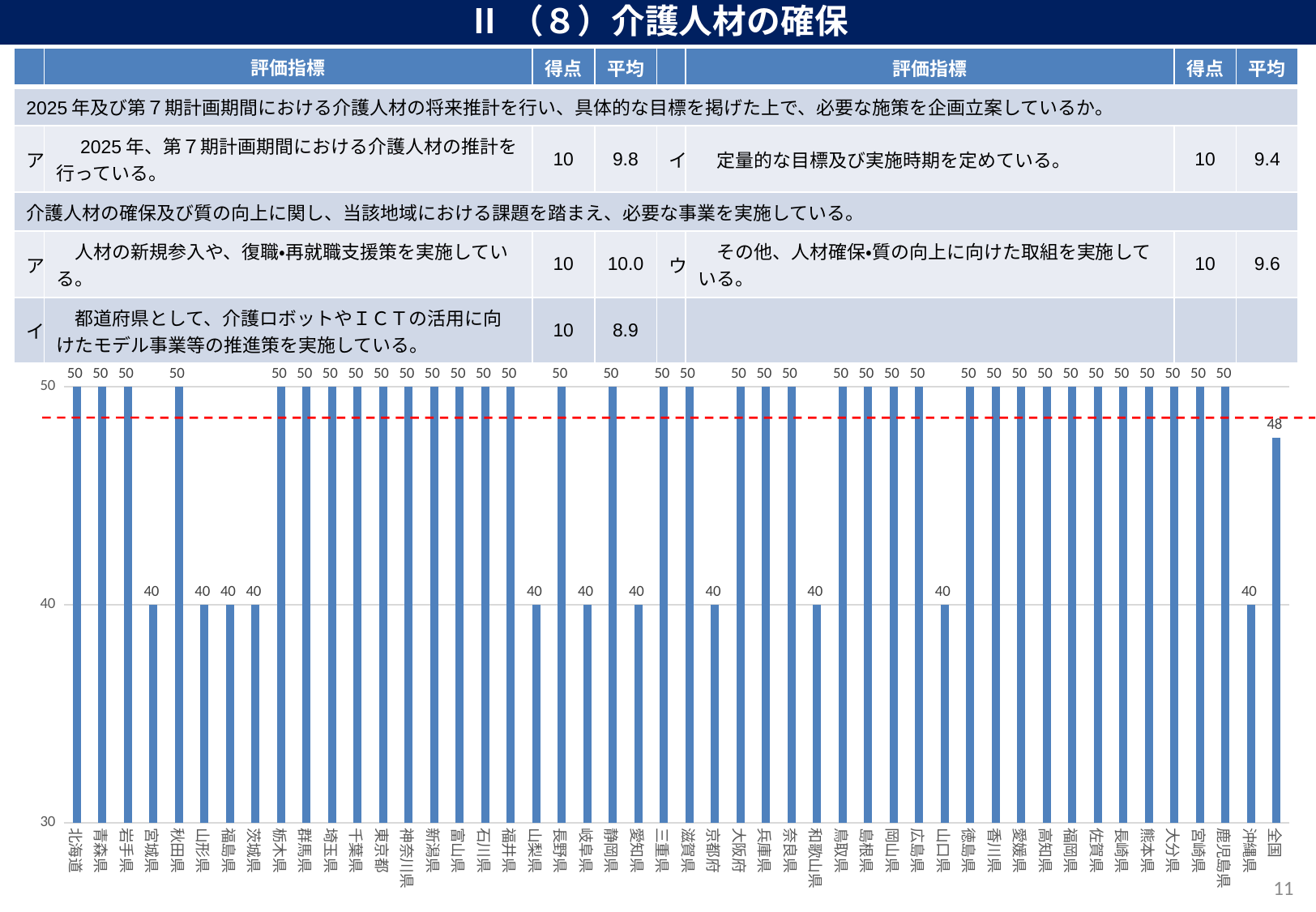
What is the difference between the values for 鹿児島県 and 全国? 2 Is the value for 全国 greater or less than 40? greater What is the value for 北海道 in the bar chart? 50 What is the value for 京都府 in the bar chart? 40 How many bars are plotted in the chart? 48 What is the value for 宮城県 in the bar chart? 40 What is the value for 全国 in the bar chart? 48 What kind of chart is shown on the slide? bar chart Which has the larger value, 愛知県 or 静岡県? 静岡県 How many prefectures have a value of 40 in the chart? 11 What is the difference between the values for 東京都 and 山梨県? 10 What is the value for 沖縄県 in the bar chart? 40